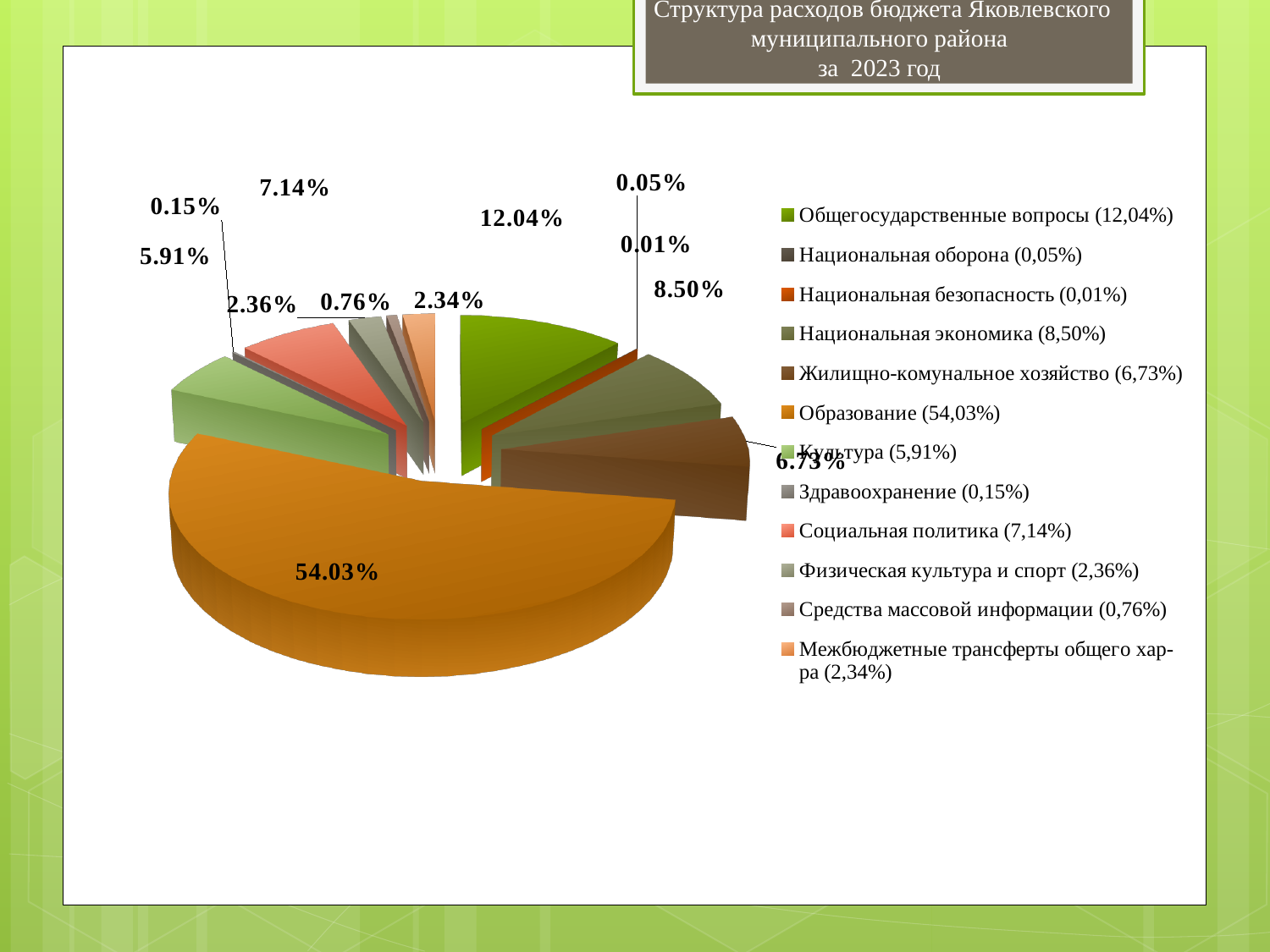
What is the value for Общегосударственные вопросы? 12.04% Which category has the smallest share of the pie? Национальная безопасность Which is larger, the share for Социальная политика or the share for Культура? Социальная политика How many categories does the legend list? 12 Which category has the largest share of the pie? Образование What is the difference between the shares for Общегосударственные вопросы and Национальная экономика? 3.54% What share of the budget expenditure goes to Образование? 54.03% What is the value for Жилищно-коммунальное хозяйство? 6.73% What is the value for Национальная экономика? 8.50% What kind of chart is shown on the slide? pie chart What is the title of the chart? Структура расходов бюджета Яковлевского муниципального района за 2023 год What is the value for Средства массовой информации? 0.76%